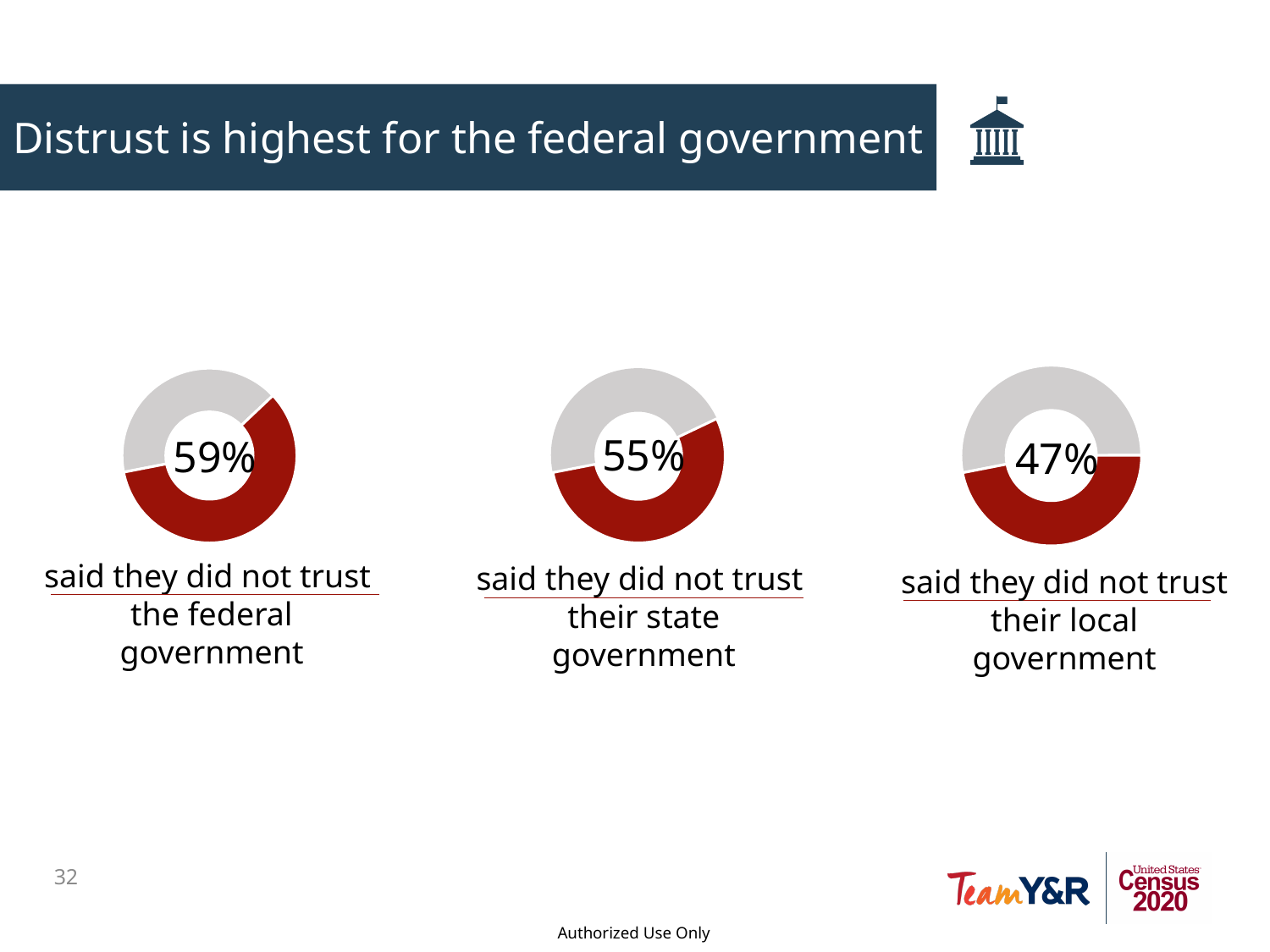
What is the title of the slide? Distrust is highest for the federal government What is the difference between the percentage who did not trust the federal government and the percentage who did not trust their state government? 4% What colour is used for the highlighted (distrust) portion of each donut chart? dark red Which level of government has the highest share of respondents saying they did not trust it? the federal government How many donut charts are shown on the slide? 3 What kind of chart is used to show the percentages on this slide? donut chart What percentage is shown in the left donut chart for those who said they did not trust the federal government? 59% What is the difference between the percentage who did not trust the federal government and the percentage who did not trust their local government? 12% Which level of government has the lowest share of respondents saying they did not trust it? their local government What percentage is shown in the right donut chart for those who said they did not trust their local government? 47% Which is larger: the percentage who did not trust their state government or the percentage who did not trust their local government? their state government What percentage is shown in the middle donut chart for those who said they did not trust their state government? 55%